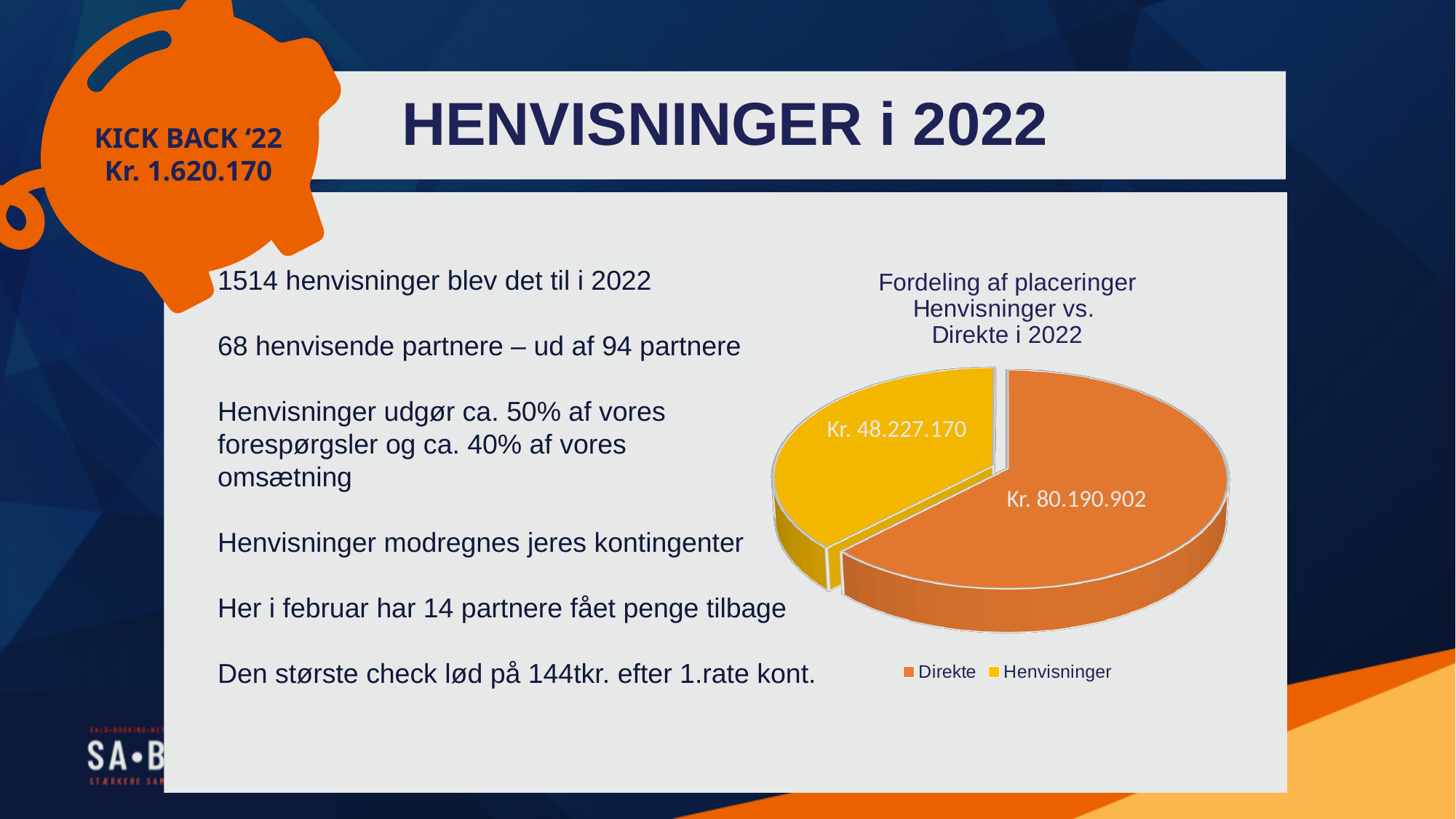
What is the title of the chart? Fordeling af placeringer Henvisninger vs. Direkte i 2022 What colour is the Henvisninger slice? Yellow What is the difference between the Direkte and Henvisninger values? Kr. 31.963.732 How many slices does the pie chart have? 2 What type of chart is shown on the slide? Pie chart What is the value of the Henvisninger slice? Kr. 48.227.170 Which is larger, Direkte or Henvisninger? Direkte What is the total of the two slices in the pie chart? Kr. 128.418.072 Which category has the largest slice? Direkte How many entries does the legend list? 2 Which category has the smallest slice? Henvisninger What is the value of the Direkte slice? Kr. 80.190.902